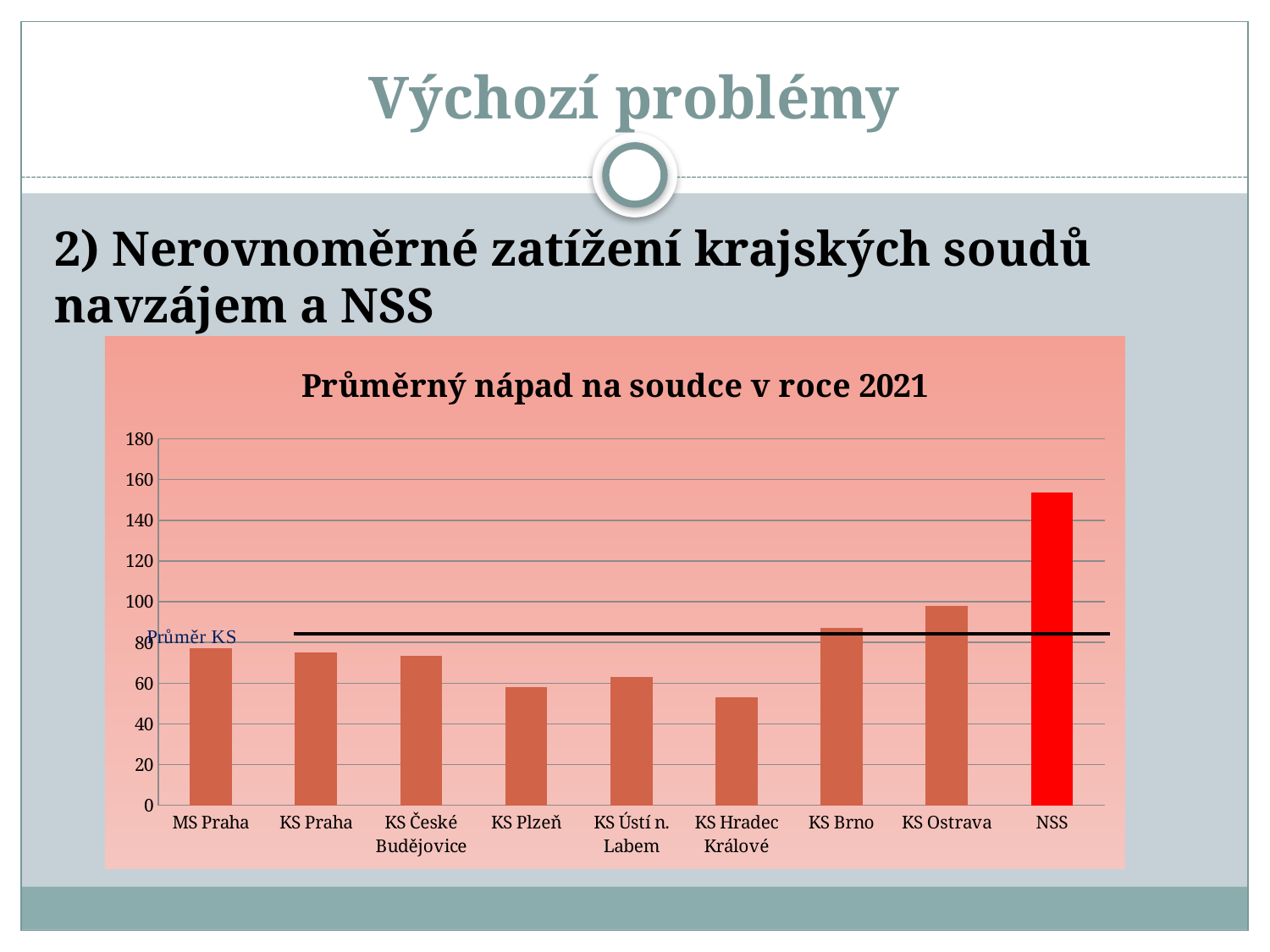
Which is larger, the value for KS Brno or the value for KS Plzeň? KS Brno Which court has the highest bar in the chart? NSS What kind of chart is shown on the slide? bar chart What is the title of the chart? Průměrný nápad na soudce v roce 2021 Is the value for NSS greater or less than 140? greater How many courts (categories) are shown on the x axis of the chart? 9 What is the label of the horizontal black line drawn across the chart? Průměr KS Is the value for KS Plzeň greater or less than 40? greater Which court has the lowest bar in the chart? KS Hradec Králové Which is larger, the value for KS Ostrava or the value for MS Praha? KS Ostrava Is the value for KS Hradec Králové greater or less than 60? less